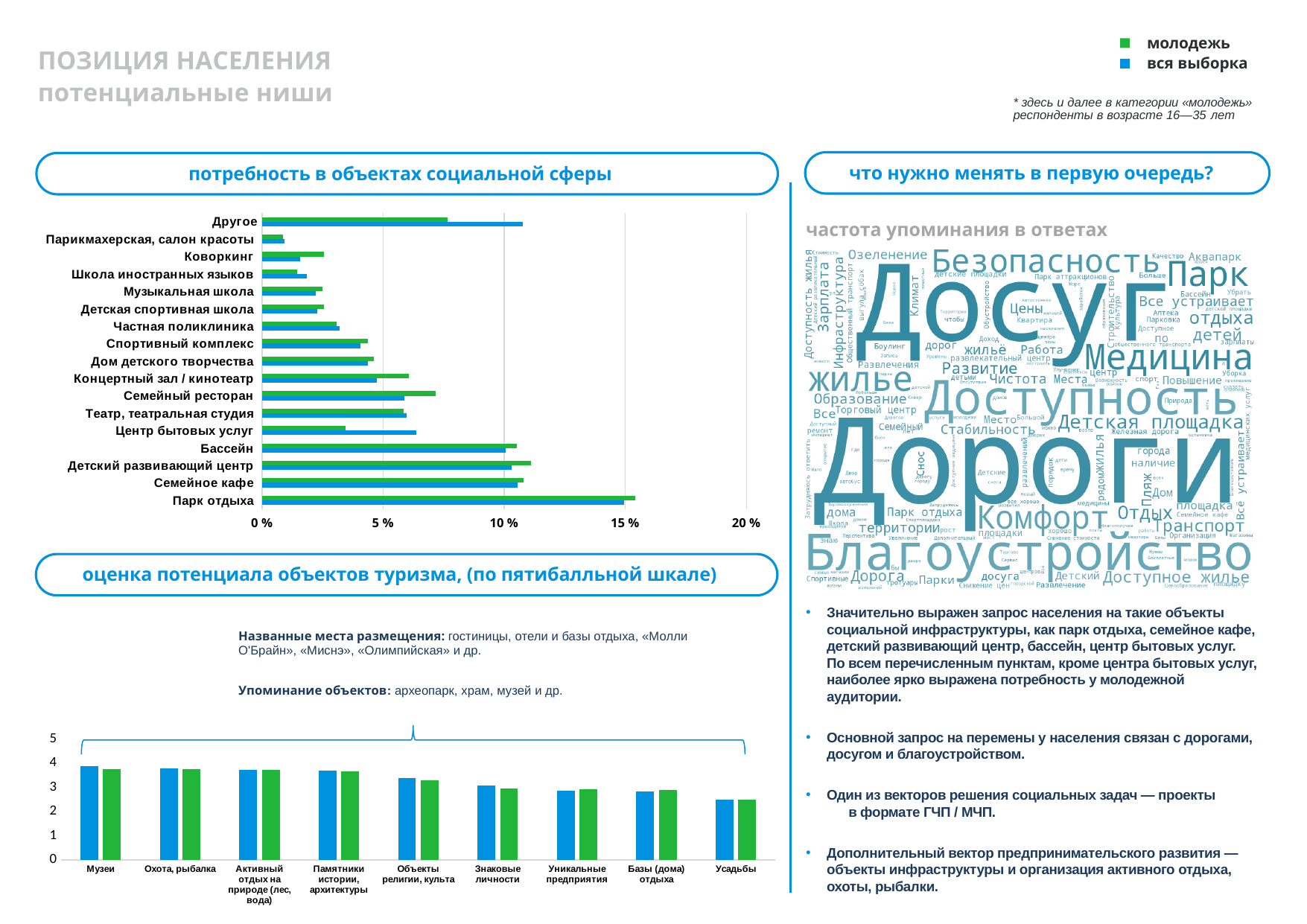
On the chart 'потребность в объектах социальной сферы', which category has the lowest values? Парикмахерская, салон красоты What kind of chart is 'потребность в объектах социальной сферы'? bar chart How many series does the legend at the top right of the slide list? 2 On the chart 'потребность в объектах социальной сферы', for Центр бытовых услуг, which series has the larger value: молодежь or вся выборка? вся выборка On the chart 'оценка потенциала объектов туризма', is the 'вся выборка' value for Музеи greater or less than 3? greater On the chart 'потребность в объектах социальной сферы', which category has the highest values? Парк отдыха On the chart 'потребность в объектах социальной сферы', is the 'вся выборка' value for Парикмахерская, салон красоты greater or less than 5 %? less On the chart 'оценка потенциала объектов туризма', which category has the lowest values? Усадьбы On the chart 'потребность в объектах социальной сферы', how many categories are listed on the vertical axis? 17 On the chart 'оценка потенциала объектов туризма', how many categories are shown on the x axis? 9 On the chart 'потребность в объектах социальной сферы', for Семейный ресторан, which series has the larger value: молодежь or вся выборка? молодежь On the chart 'потребность в объектах социальной сферы', is the 'молодежь' value for Парк отдыха greater or less than 10 %? greater